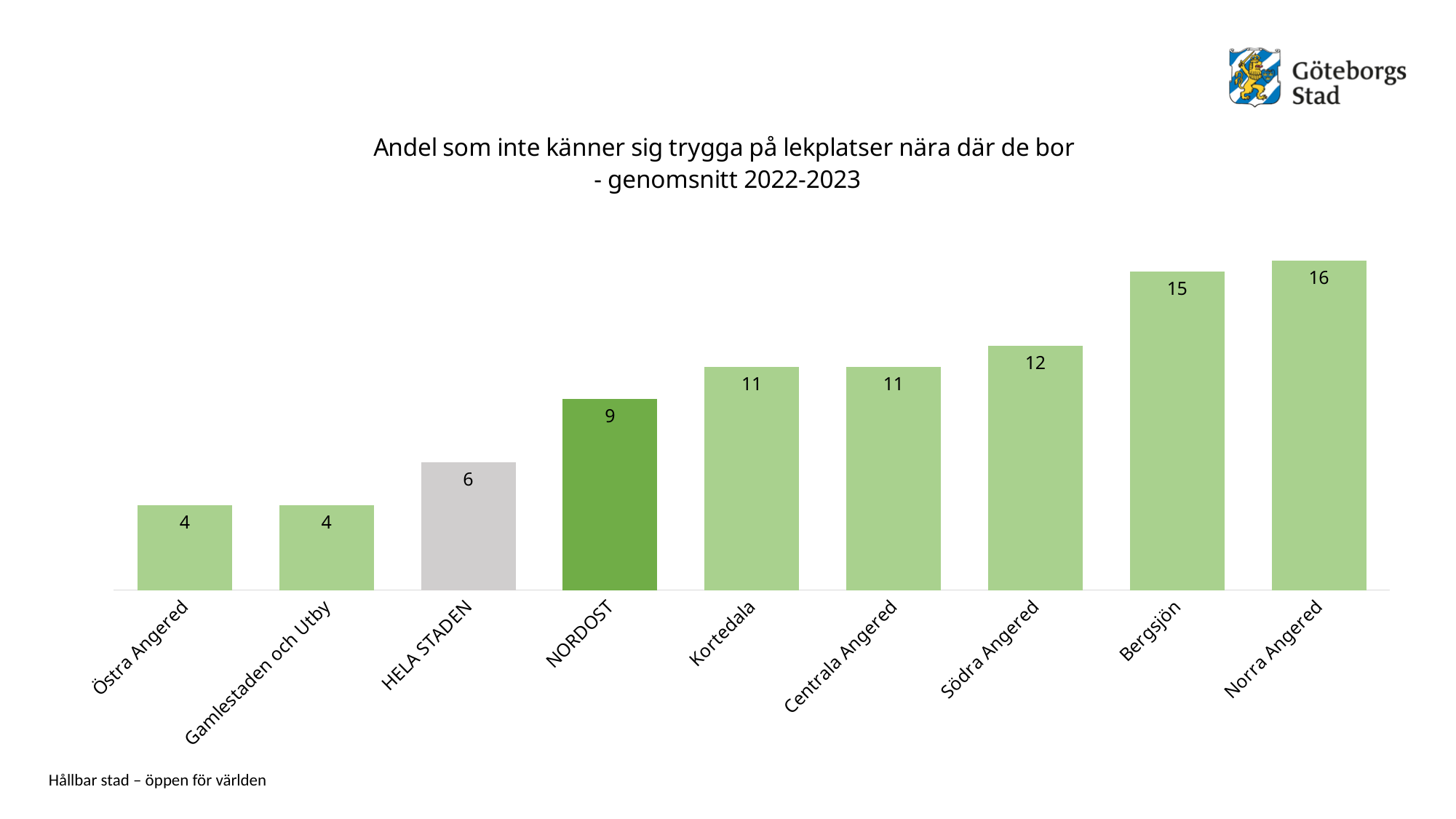
Do the values generally rise or fall from left to right along the x axis? rise Which bar is coloured grey? HELA STADEN What is the difference between the values for NORDOST and HELA STADEN? 3 What kind of chart is shown on the slide? bar chart Which is larger, the value for Kortedala or the value for Bergsjön? Bergsjön What is the value for Bergsjön? 15 What is the value for NORDOST? 9 What is the value for HELA STADEN? 6 Which category has the highest value? Norra Angered How many categories are shown on the x axis? 9 What is the value for Södra Angered? 12 What is the difference between the values for Norra Angered and Östra Angered? 12